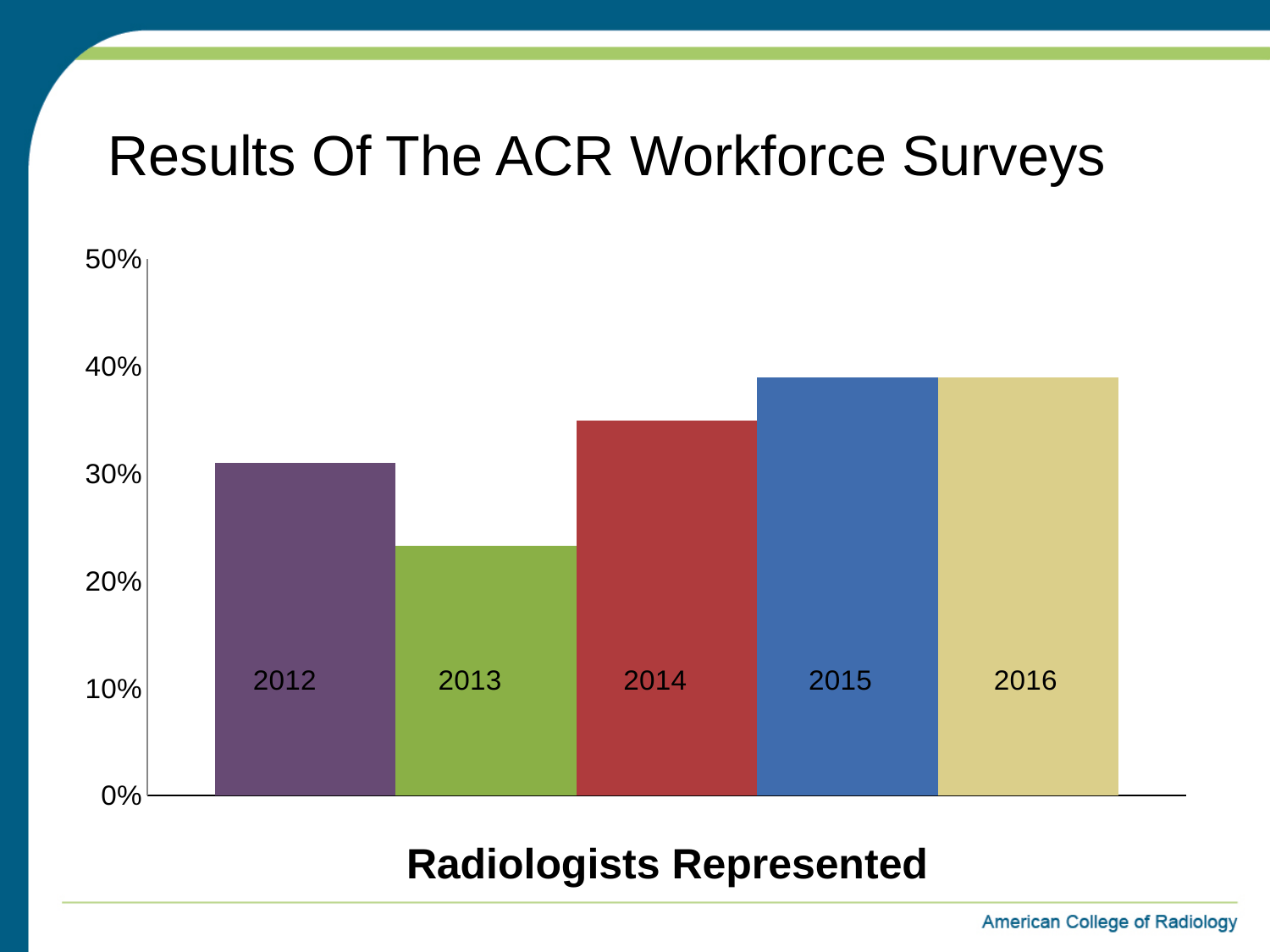
What label appears below the chart's x axis? Radiologists Represented Is the value for 2013 greater or less than 30%? less Is the value for 2014 greater or less than 30%? greater How many years (bars) are shown in the chart? 5 Do the values rise or fall from 2013 to 2015? rise Is the value for 2015 greater or less than 30%? greater Which is larger, the value for 2013 or the value for 2014? 2014 Which year has the lowest value in the chart? 2013 Which is larger, the value for 2012 or the value for 2015? 2015 What kind of chart is shown on the slide? bar chart